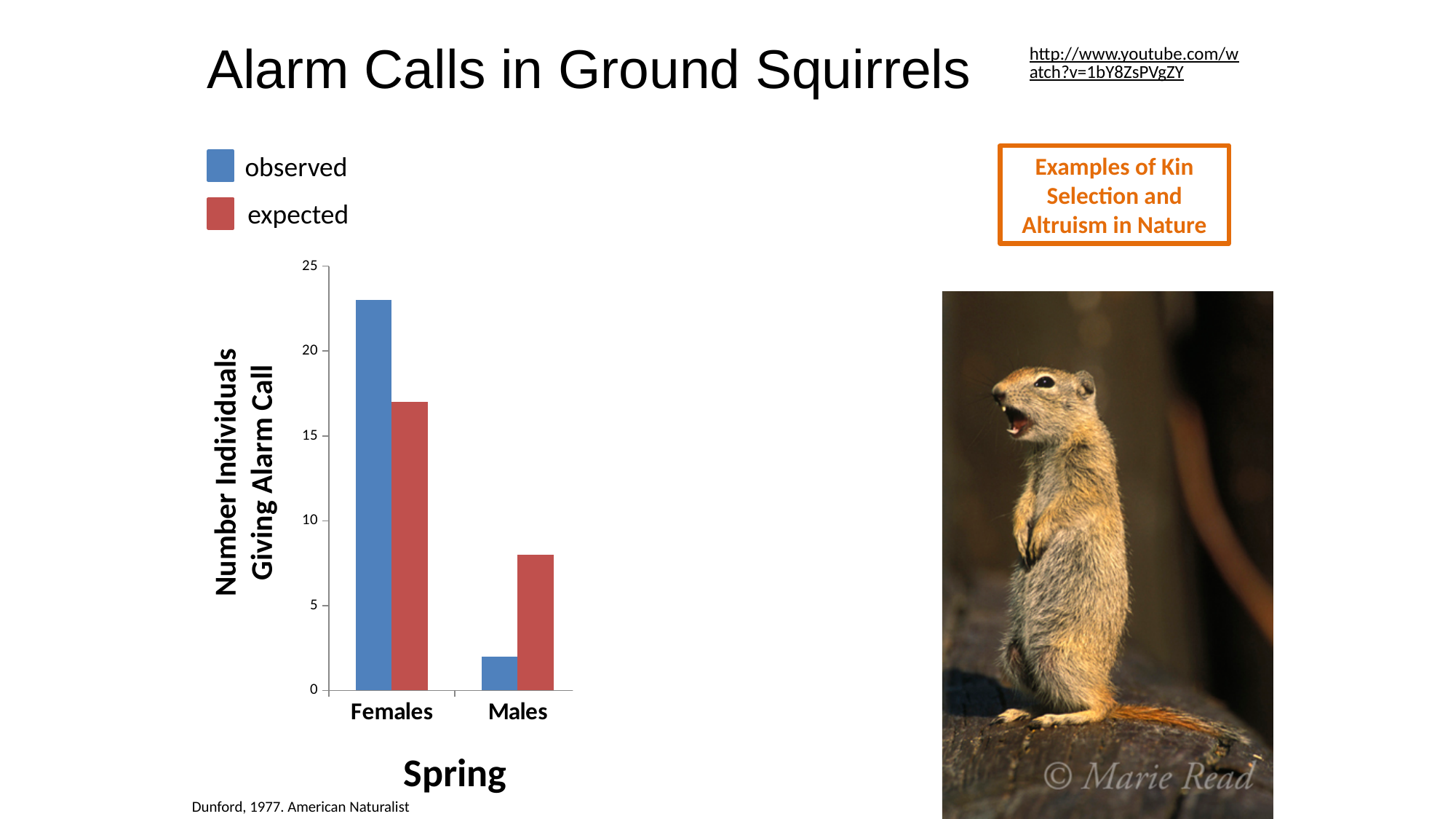
What kind of chart is shown on the slide? bar chart How many categories are shown on the x axis? 2 How many series does the legend list? 2 Is the observed value for Males greater or less than 5? less Which category has the highest observed value? Females Is the expected value for Females greater or less than 20? less Is the observed value for Females greater or less than 20? greater Which category has the lowest observed value? Males For Males, which is larger: the observed value or the expected value? expected What colour represents the expected series in the legend? red For Females, which is larger: the observed value or the expected value? observed